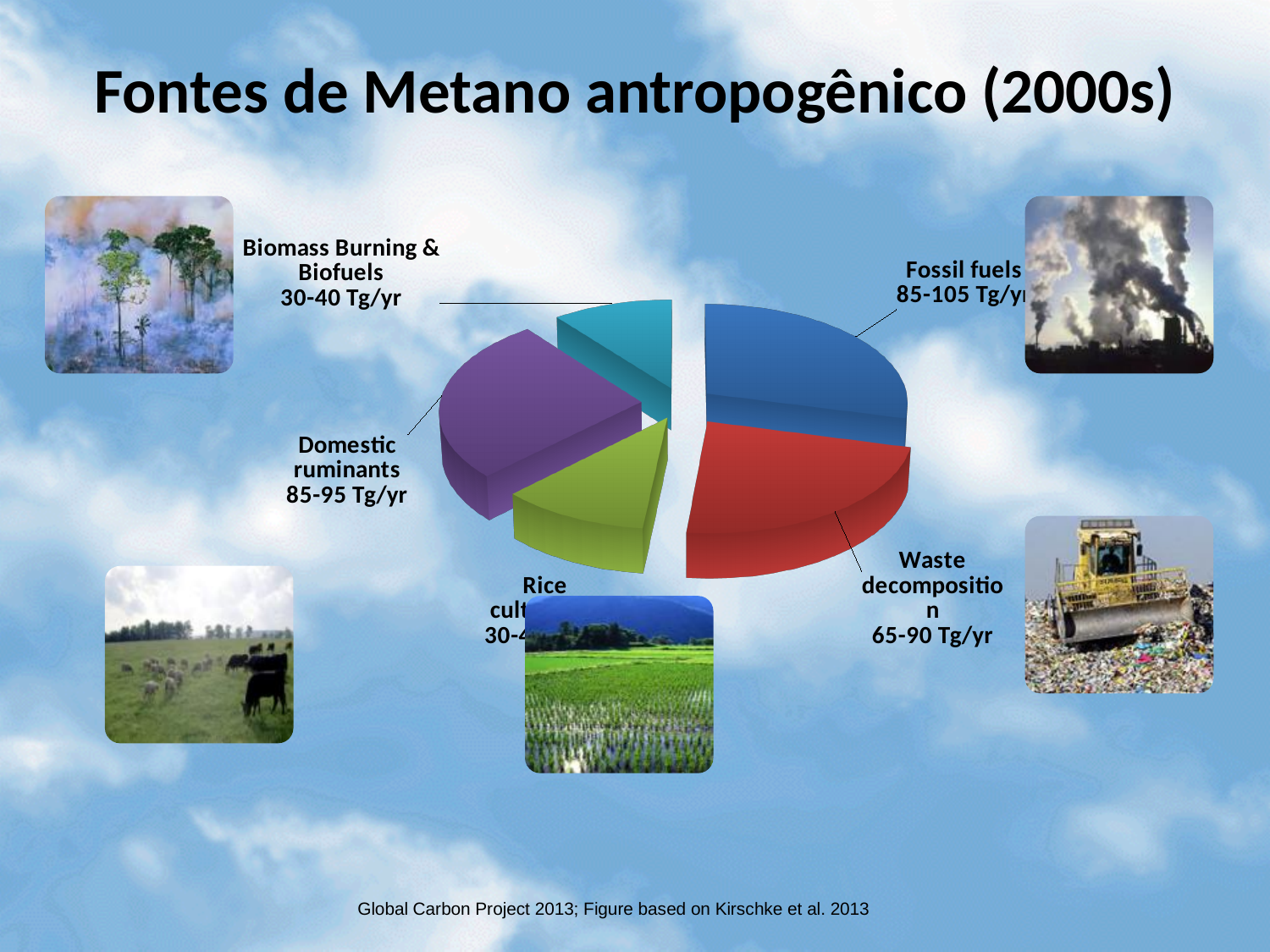
What is the value labelled for Fossil fuels? 85-105 Tg/yr Which is larger, the slice for Domestic ruminants or the slice for Biomass Burning & Biofuels? Domestic ruminants What is the value labelled for Biomass Burning & Biofuels? 30-40 Tg/yr What colour is the Fossil fuels slice? blue Which is larger, the slice for Fossil fuels or the slice for Biomass Burning & Biofuels? Fossil fuels Which source has the largest slice of the pie? Fossil fuels What kind of chart is shown on the slide? pie chart What colour is the Domestic ruminants slice? purple How many slices does the pie chart have? 5 What is the value labelled for Waste decomposition? 65-90 Tg/yr What is the value labelled for Domestic ruminants? 85-95 Tg/yr